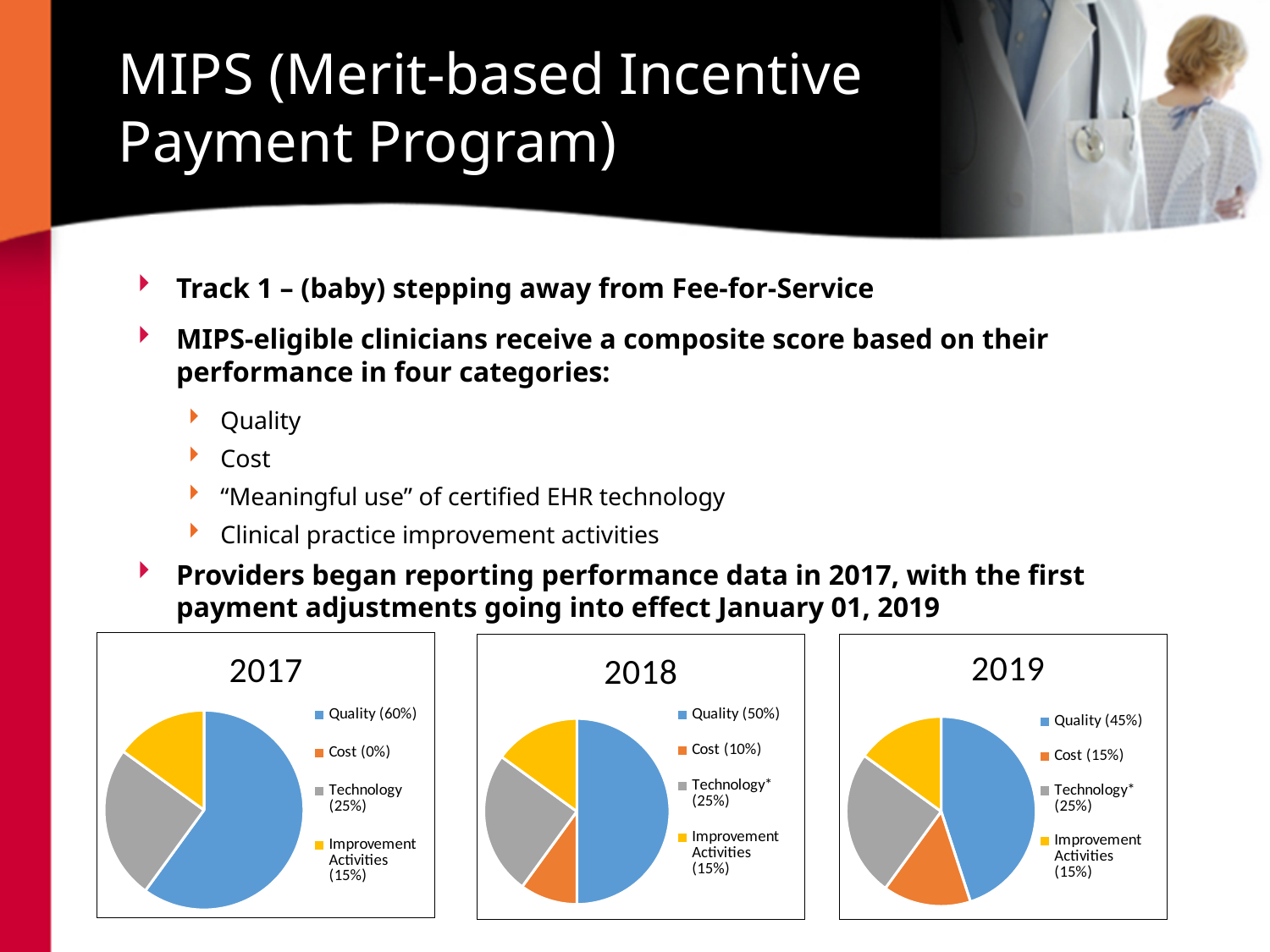
In the 2019 chart, which category has the largest share? Quality Across the 2017, 2018 and 2019 charts, does the Quality share rise or fall over the years? Fall In the 2018 chart, what share does Cost have? 10% How many categories does the 2017 chart's legend list? 4 In the 2018 chart, which is larger, the Technology* share or the Improvement Activities share? Technology* What kind of chart is the 2019 chart? Pie chart In the 2017 chart, what share does Quality have? 60% In the 2017 chart, what share does Cost have? 0% In the 2018 chart, which category has the smallest share? Cost In the 2019 chart, what share does Quality have? 45% In the 2019 chart, what is the difference between the Quality share and the Technology* share? 20% What is the title of the middle chart? 2018